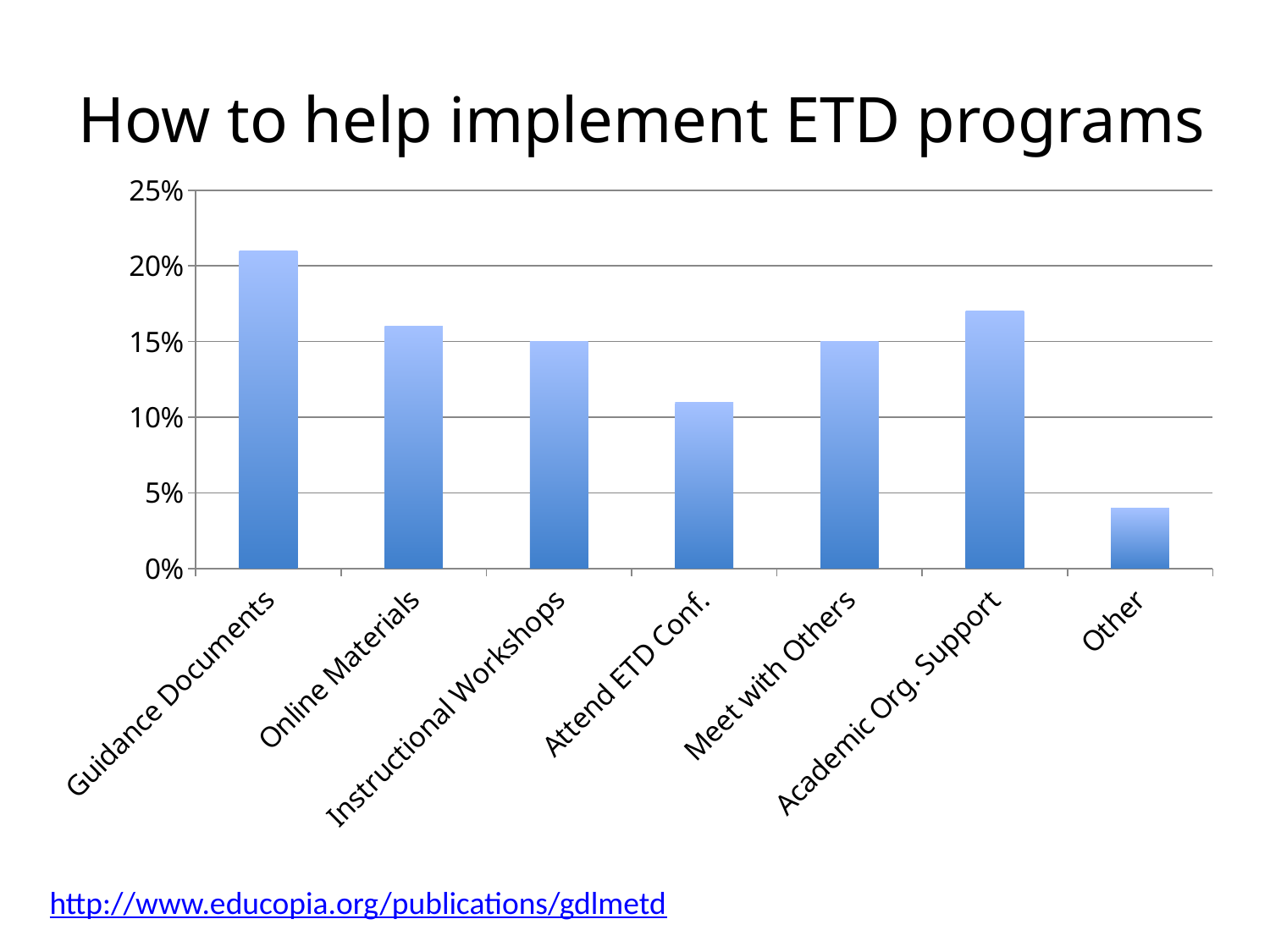
What is the title of the chart? How to help implement ETD programs Which is larger, the value for Online Materials or the value for Attend ETD Conf.? Online Materials Is the value for Academic Org. Support greater or less than 20%? less Is the value for Attend ETD Conf. greater or less than 10%? greater Is the value for Other greater or less than 5%? less Which category has the lowest value? Other Which category has the highest value? Guidance Documents How many categories are shown on the x axis of the chart? 7 What type of chart is shown on the slide? bar chart What is the value for Instructional Workshops? 15% Which is larger, the value for Guidance Documents or the value for Academic Org. Support? Guidance Documents